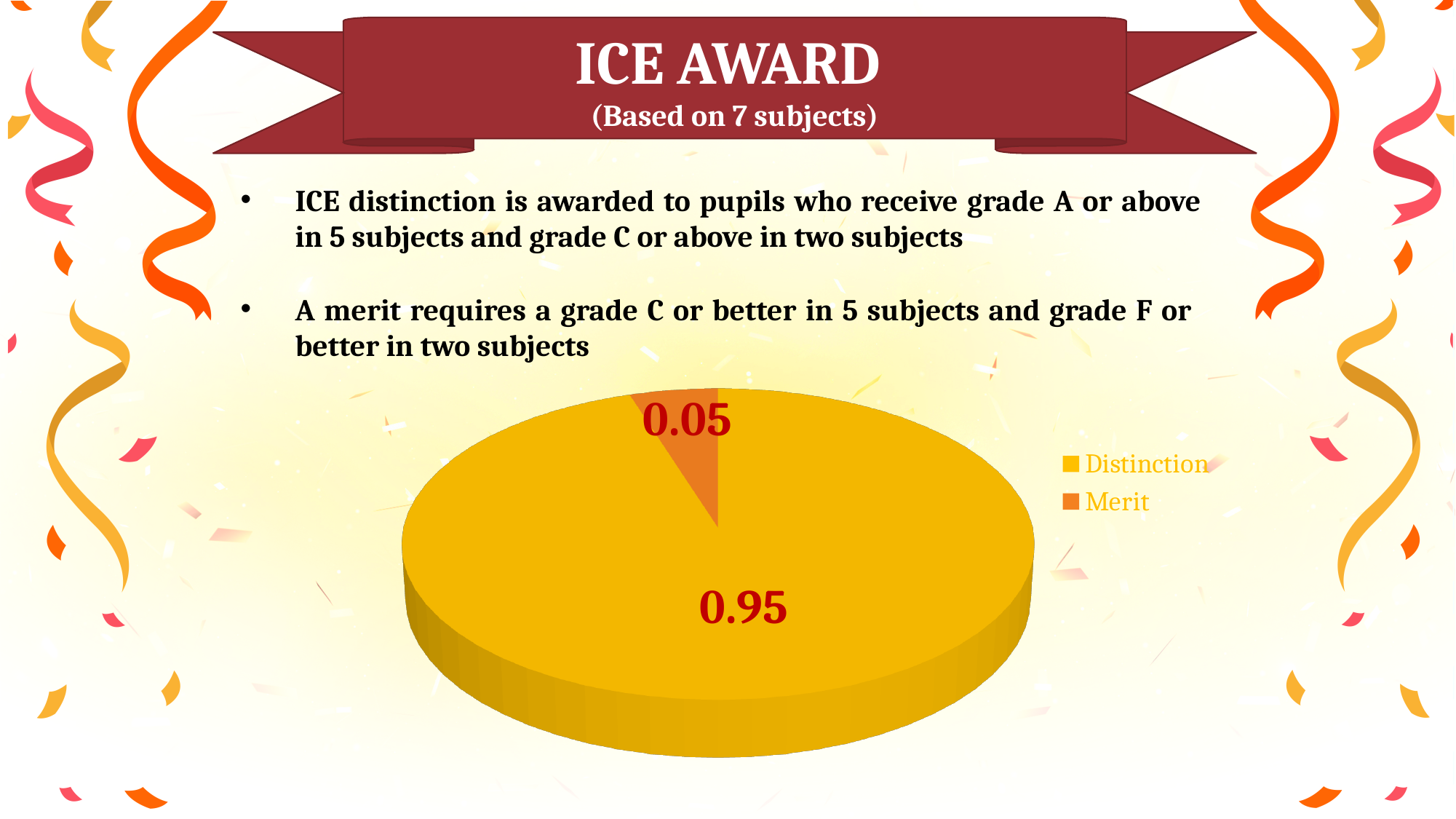
Which is larger in the pie chart, Distinction or Merit? Distinction What value is shown for the Distinction slice of the pie chart? 0.95 What value is shown for the Merit slice of the pie chart? 0.05 How many slices does the pie chart have? 2 Which category has the largest slice in the pie chart? Distinction What is the difference between the Distinction value and the Merit value in the pie chart? 0.9 What colour is the Merit slice in the pie chart? Orange Which category has the smallest slice in the pie chart? Merit What colour is the Distinction slice in the pie chart? Yellow How many entries does the pie chart's legend list? 2 What kind of chart is shown on the slide? Pie chart